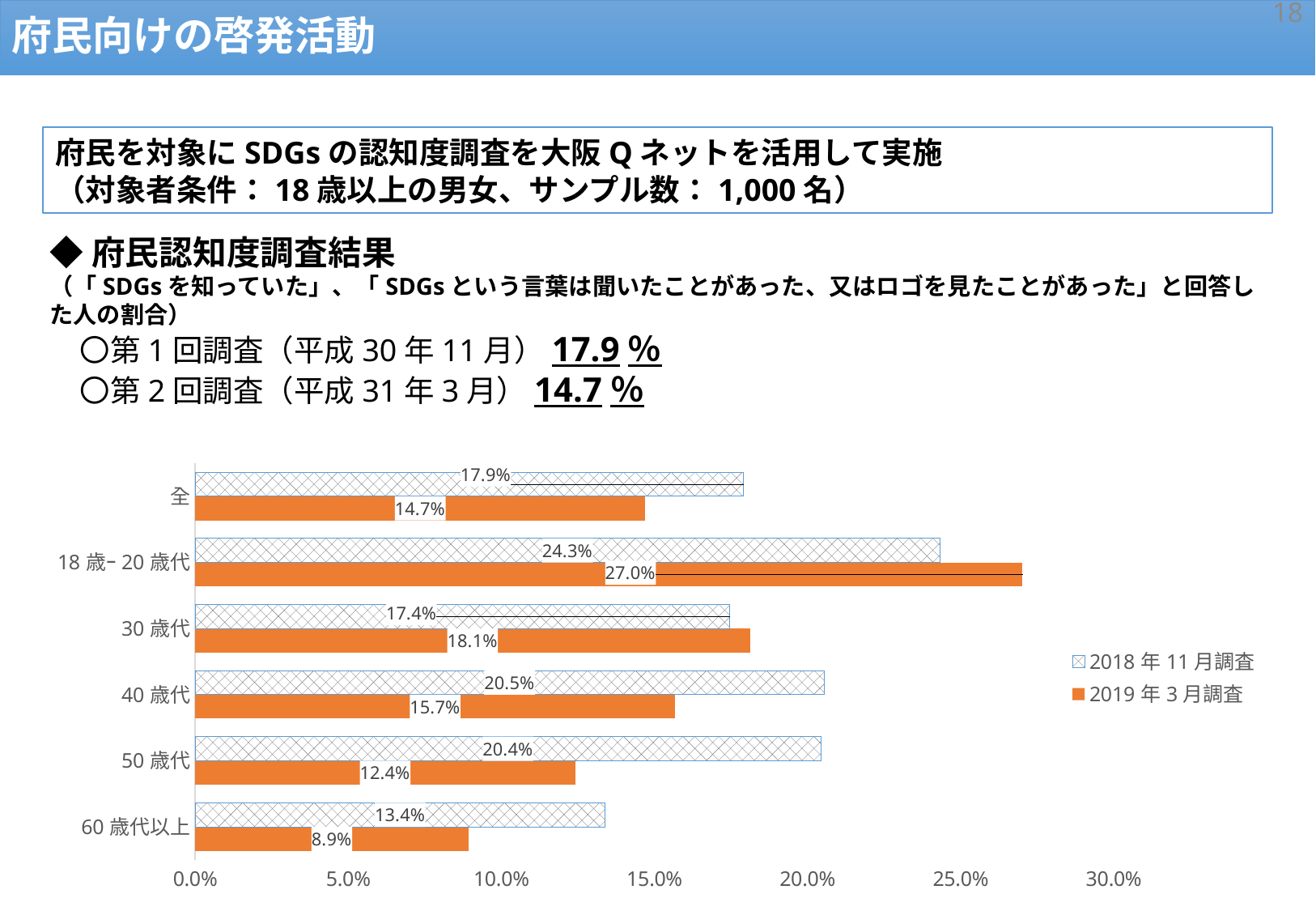
What is the value for 40歳代 in the 2019年3月調査 series? 15.7% How many series does the chart legend list? 2 For 30歳代, which survey has the larger value, 2018年11月調査 or 2019年3月調査? 2019年3月調査 What is the value for 60歳代以上 in the 2018年11月調査 series? 13.4% Which series is drawn with solid orange bars? 2019年3月調査 How many age categories are plotted on the chart? 6 Which category has the highest value in the 2018年11月調査 series? 18歳-20歳代 Which category has the lowest value in the 2019年3月調査 series? 60歳代以上 Is the 2018年11月調査 value for 40歳代 greater or less than 15.0%? greater What is the value for 18歳-20歳代 in the 2019年3月調査 series? 27.0% What is the difference between the 2018年11月調査 and 2019年3月調査 values for 50歳代? 8.0% What kind of chart is shown on the slide? bar chart